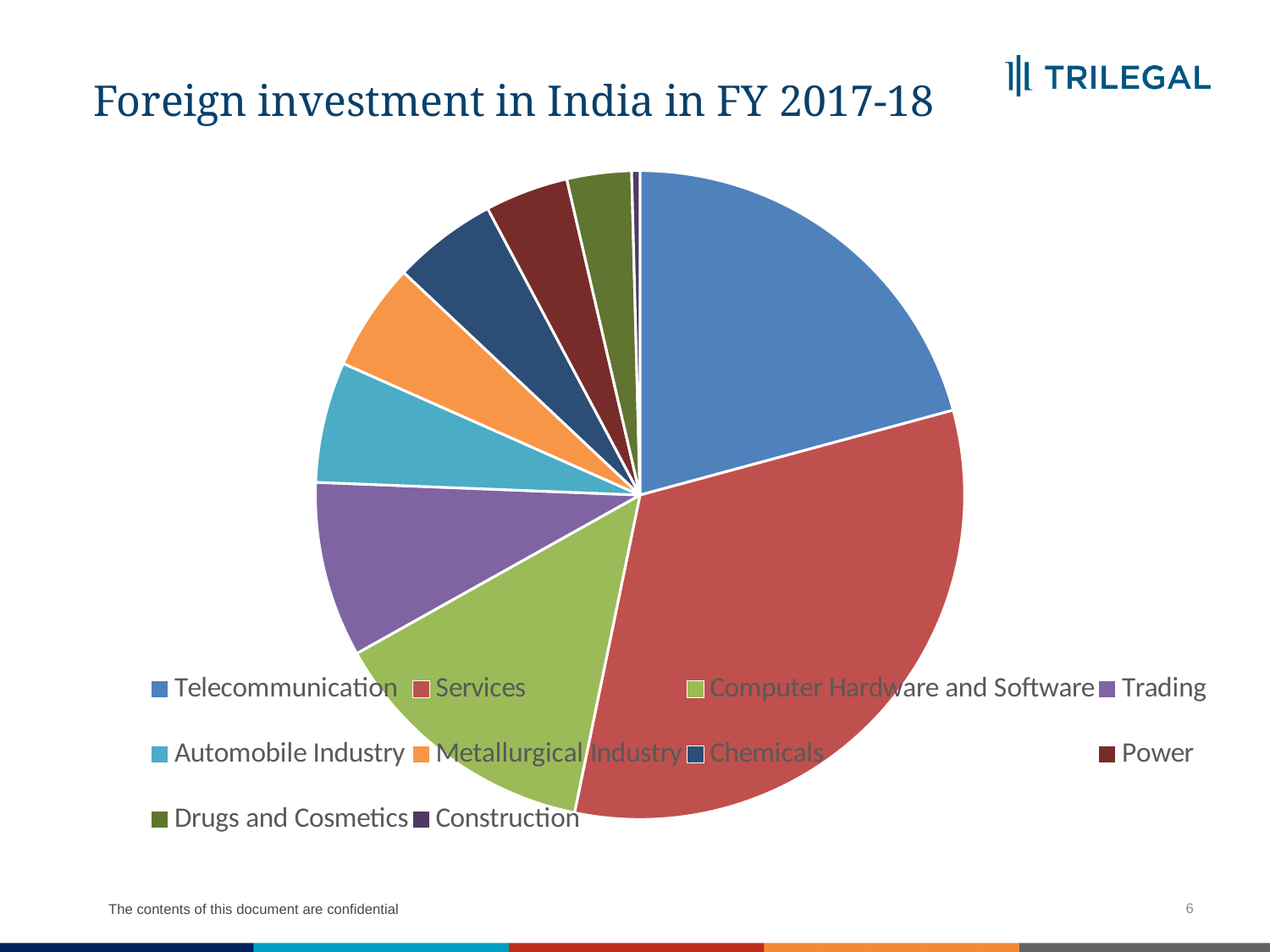
What kind of chart is shown on the slide? Pie chart How many sectors are shown in the pie chart? 10 What colour is the Services slice in the pie chart? Red Which slice is larger, Computer Hardware and Software or Power? Computer Hardware and Software Which sector has the largest slice of the pie? Services Which sector has the smallest slice of the pie? Construction Which slice is larger, Trading or Construction? Trading What is the title of the chart? Foreign investment in India in FY 2017-18 Which slice is larger, Computer Hardware and Software or Automobile Industry? Computer Hardware and Software